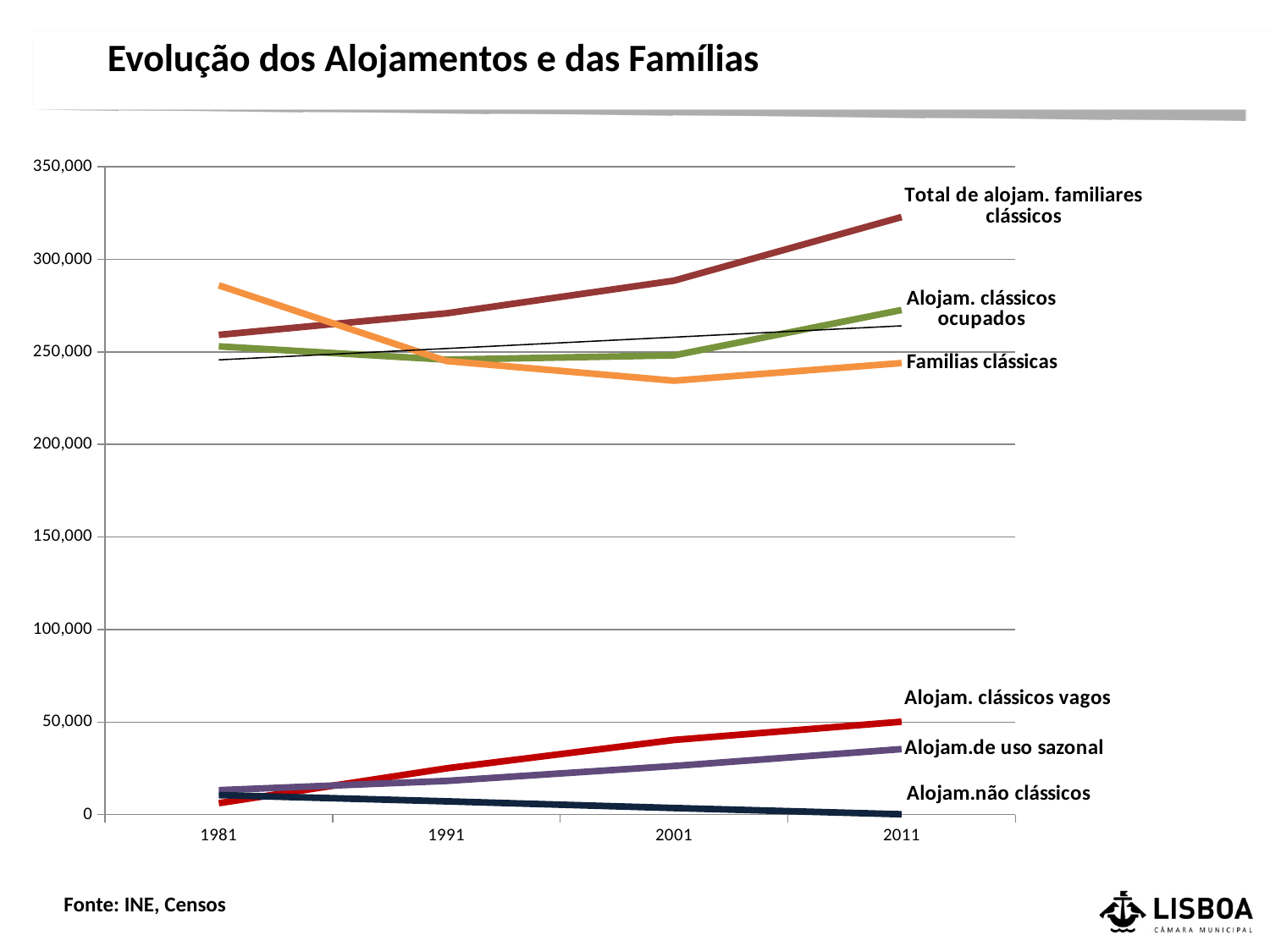
What kind of chart is shown on the slide? line chart Which series has the highest value in 2011? Total de alojam. familiares clássicos In 1981, which is larger: Familias clássicas or Total de alojam. familiares clássicos? Familias clássicas Which series has the lowest value in 2011? Alojam.não clássicos Does the value for Familias clássicas rise or fall from 1981 to 2001? fall Is the value for Alojam.de uso sazonal in 2011 greater or less than 50,000? less How many years are marked on the x axis of the chart? 4 Is the value for Total de alojam. familiares clássicos in 2011 greater or less than 300,000? greater Does the value for Alojam.não clássicos rise or fall from 1981 to 2011? fall Does the value for Total de alojam. familiares clássicos rise or fall from 1981 to 2011? rise How many labelled series does the chart show? 6 Is the value for Familias clássicas in 1981 greater or less than 250,000? greater